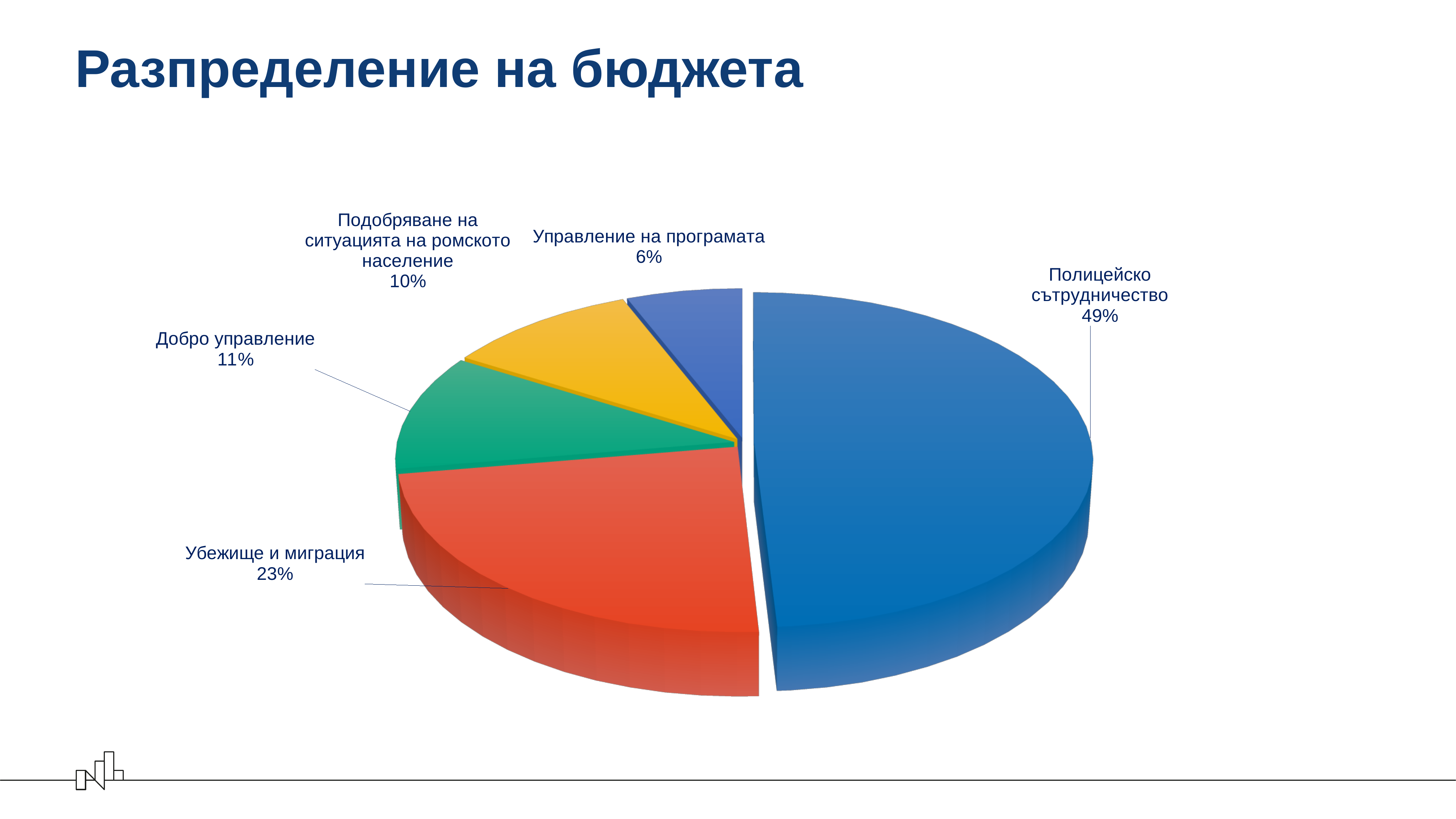
What share of the budget goes to Убежище и миграция? 23% What share of the budget goes to Полицейско сътрудничество? 49% How many categories are shown in the pie chart? 5 What share of the budget goes to Подобряване на ситуацията на ромското население? 10% What kind of chart is shown on the slide? Pie chart Which category has the smallest share of the budget? Управление на програмата Which category has the largest share of the budget? Полицейско сътрудничество What is the difference in percentage points between Полицейско сътрудничество and Убежище и миграция? 26 What is the title of the slide? Разпределение на бюджета Which has a larger share, Добро управление or Управление на програмата? Добро управление